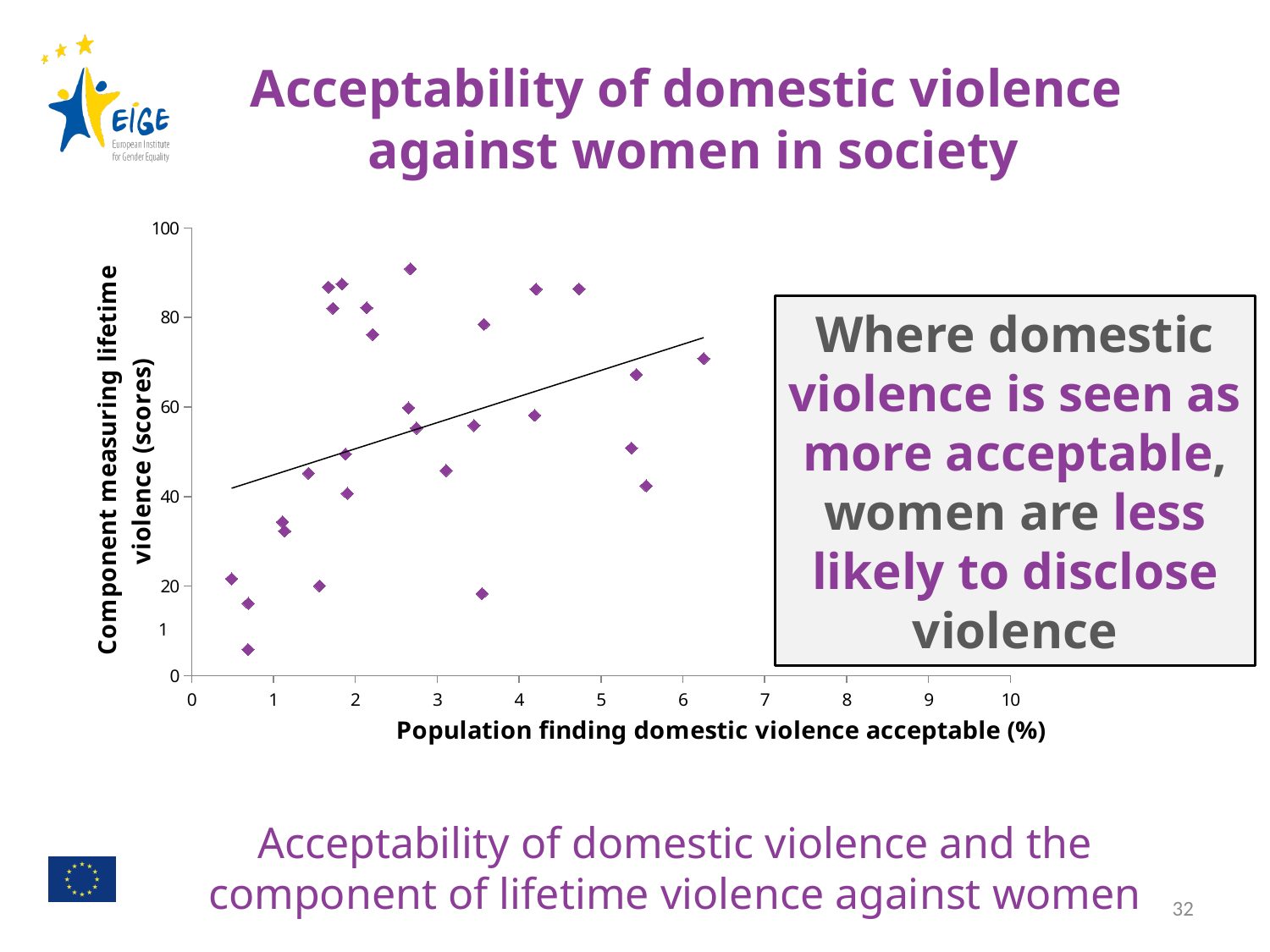
What is the title of the y axis of the chart? Component measuring lifetime violence (scores) What is the title of the x axis of the chart? Population finding domestic violence acceptable (%) What is the highest value shown on the y axis of the chart? 100 What is the highest value shown on the x axis of the chart? 10 What kind of chart is shown on the slide? Scatter plot Does the trend line in the scatter plot rise or fall as the population finding domestic violence acceptable increases? Rises